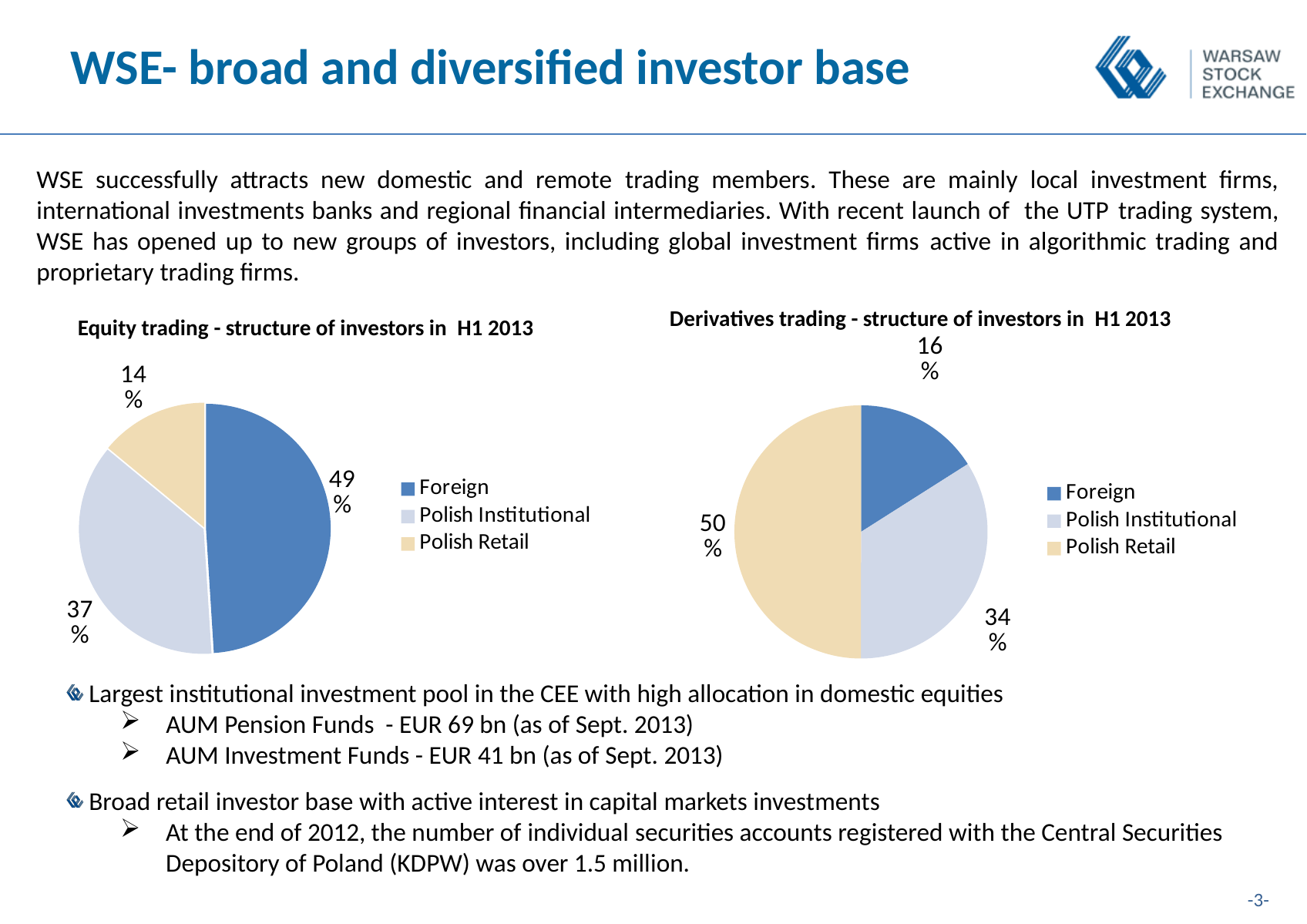
What type of chart is the 'Equity trading - structure of investors in H1 2013' chart? Pie chart In the 'Equity trading - structure of investors in H1 2013' chart, what share do Polish Institutional investors hold? 37% How many categories does the legend of the 'Derivatives trading - structure of investors in H1 2013' chart list? 3 In the 'Derivatives trading - structure of investors in H1 2013' chart, what share do Polish Institutional investors hold? 34% In the 'Equity trading - structure of investors in H1 2013' chart, what share do Polish Retail investors hold? 14% In the 'Derivatives trading - structure of investors in H1 2013' chart, what share do Foreign investors hold? 16% In the 'Equity trading - structure of investors in H1 2013' chart, which investor group has the largest share? Foreign In the 'Derivatives trading - structure of investors in H1 2013' chart, which investor group has the smallest share? Foreign In the 'Equity trading - structure of investors in H1 2013' chart, what is the difference between the Foreign and Polish Retail shares? 35% In the 'Derivatives trading - structure of investors in H1 2013' chart, what share do Polish Retail investors hold? 50% In the 'Derivatives trading - structure of investors in H1 2013' chart, which is larger: the Polish Institutional share or the Foreign share? Polish Institutional In the 'Equity trading - structure of investors in H1 2013' chart, what share do Foreign investors hold? 49%